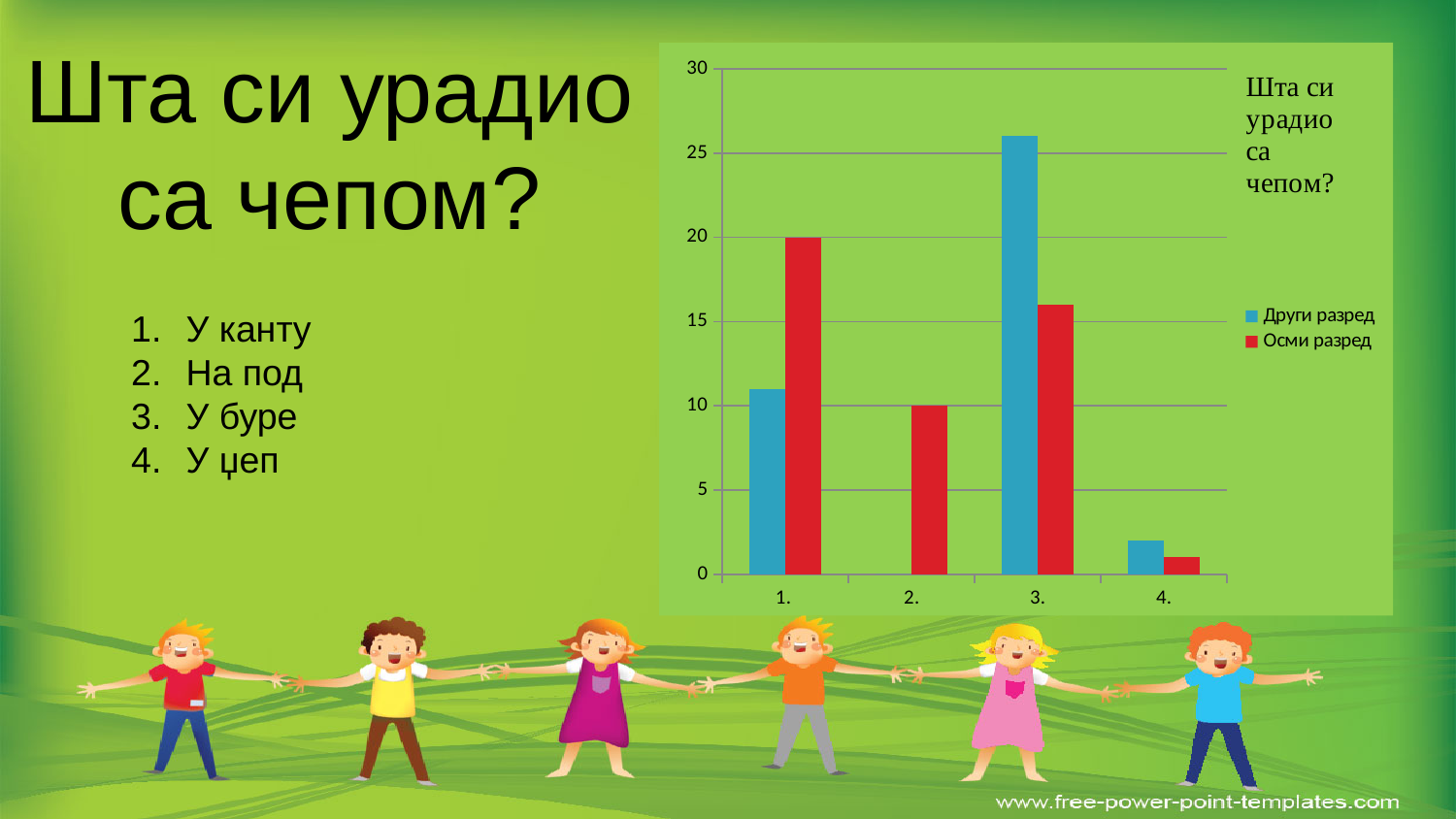
In category 3., which series has the larger value, Други разред or Осми разред? Други разред How many series does the chart legend list? 2 Is the value for Други разред in category 3. greater or less than 25? greater What is the value for Осми разред in category 1.? 20 What kind of chart is shown on the slide? bar chart Which category has the highest value for Осми разред? 1. In category 1., which series has the larger value, Други разред or Осми разред? Осми разред Which category has the highest value for Други разред? 3. What is the title of the chart? Шта си урадио са чепом? How many categories are shown on the x axis of the chart? 4 What is the value for Осми разред in category 2.? 10 Which category has the lowest value for Осми разред? 4.